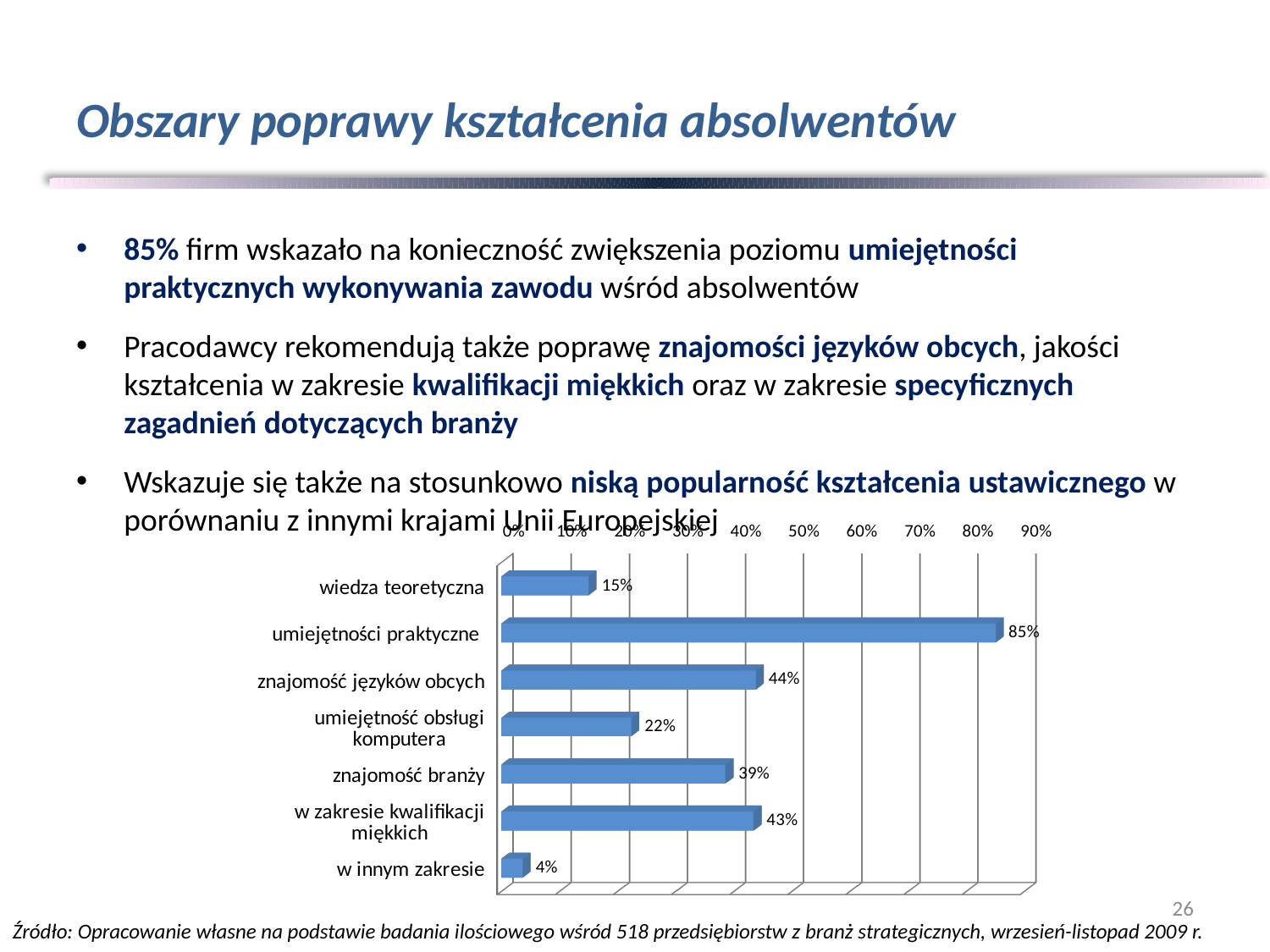
Which category has the highest value? umiejętności praktyczne Is the value for "w zakresie kwalifikacji miękkich" greater or less than 30%? greater What is the value for "znajomość języków obcych"? 44% What is the value for "umiejętność obsługi komputera"? 22% What is the value for "umiejętności praktyczne"? 85% What is the difference between the values for "znajomość branży" and "w innym zakresie"? 35% Which category has the lowest value? w innym zakresie What kind of chart is shown on the slide? bar chart Which is larger, the value for "znajomość branży" or the value for "umiejętność obsługi komputera"? znajomość branży How many categories are shown in the chart? 7 What is the difference between the values for "umiejętności praktyczne" and "znajomość języków obcych"? 41% What is the value for "wiedza teoretyczna"? 15%